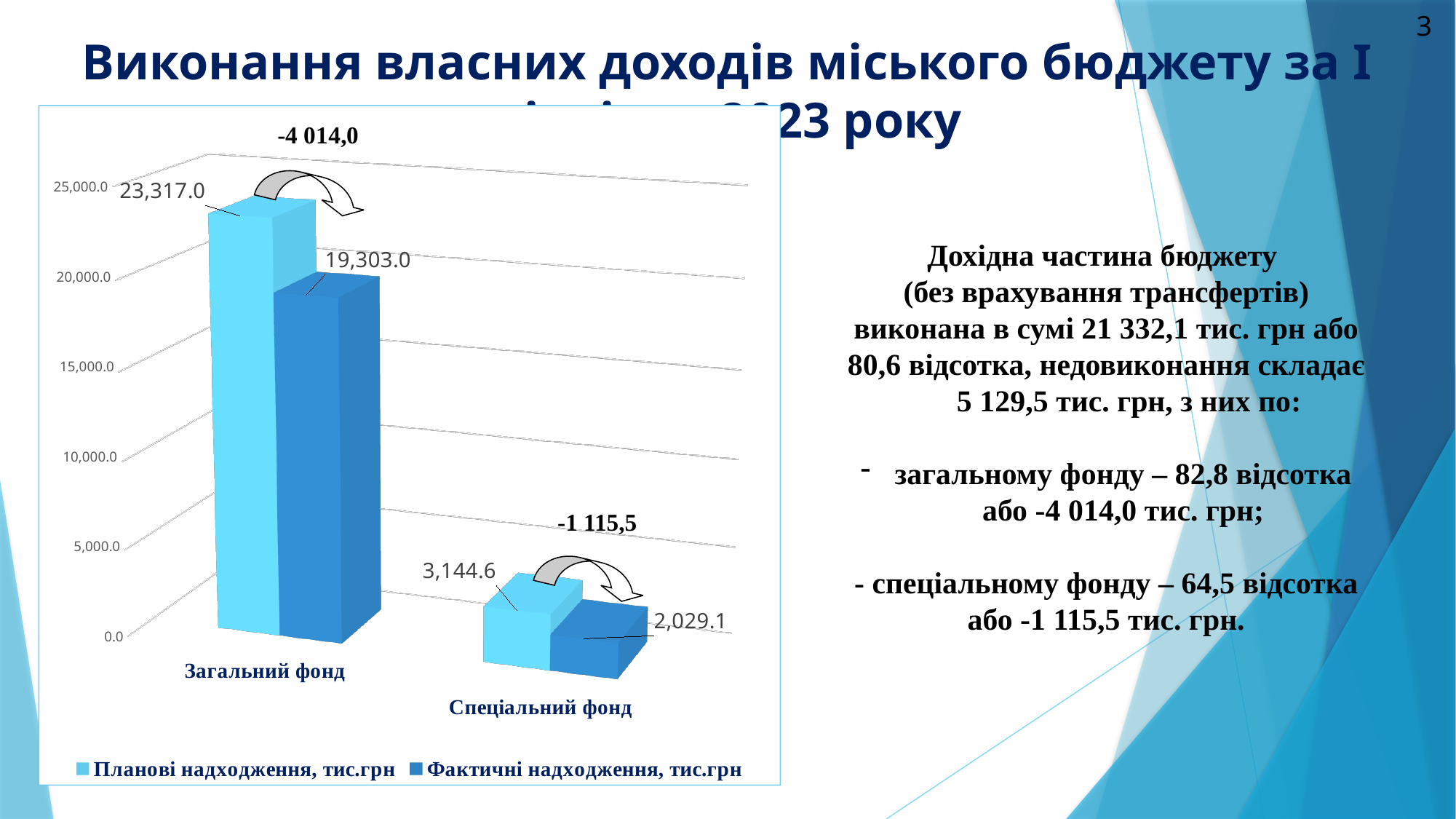
Which is larger for Спеціальний фонд: planned revenue or actual revenue? Planned revenue (Планові надходження) What is the difference between planned and actual revenue for Загальний фонд? 4,014.0 How many categories are shown on the x axis of the chart? 2 Which category has the highest planned revenue? Загальний фонд What is the planned revenue (Планові надходження) for Спеціальний фонд? 3,144.6 What is the actual revenue (Фактичні надходження) for Загальний фонд? 19,303.0 What is the difference between planned and actual revenue for Спеціальний фонд? 1,115.5 Which category has the lowest actual revenue? Спеціальний фонд What is the actual revenue (Фактичні надходження) for Спеціальний фонд? 2,029.1 What is the planned revenue (Планові надходження) for Загальний фонд? 23,317.0 How many series does the chart legend list? 2 What kind of chart is shown on the slide? Bar chart